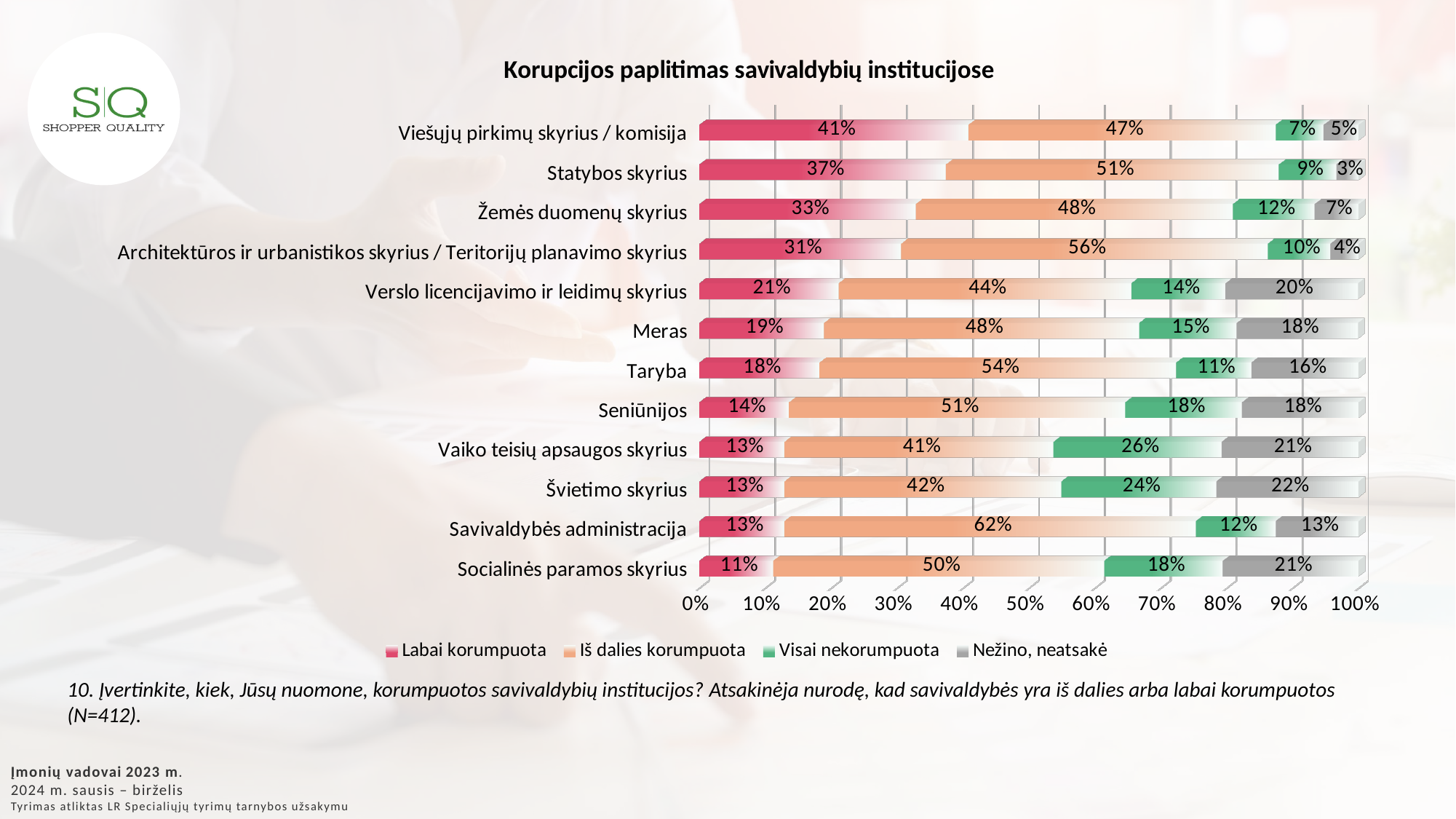
How many series does the legend list? 4 What percentage of respondents rated Viešųjų pirkimų skyrius / komisija as "Labai korumpuota"? 41% What is the "Iš dalies korumpuota" value for Savivaldybės administracija? 62% What is the difference between the "Labai korumpuota" values for Statybos skyrius and Meras? 18% How many institutions are listed on the chart? 12 What type of chart is shown on the slide? Stacked bar chart Which has a larger "Iš dalies korumpuota" value: Taryba or Seniūnijos? Taryba Which institution has the highest "Labai korumpuota" share? Viešųjų pirkimų skyrius / komisija What is the "Nežino, neatsakė" value for Švietimo skyrius? 22% Which institution has the lowest "Labai korumpuota" share? Socialinės paramos skyrius What is the title of the chart? Korupcijos paplitimas savivaldybių institucijose Which institution has the highest "Visai nekorumpuota" share? Vaiko teisių apsaugos skyrius